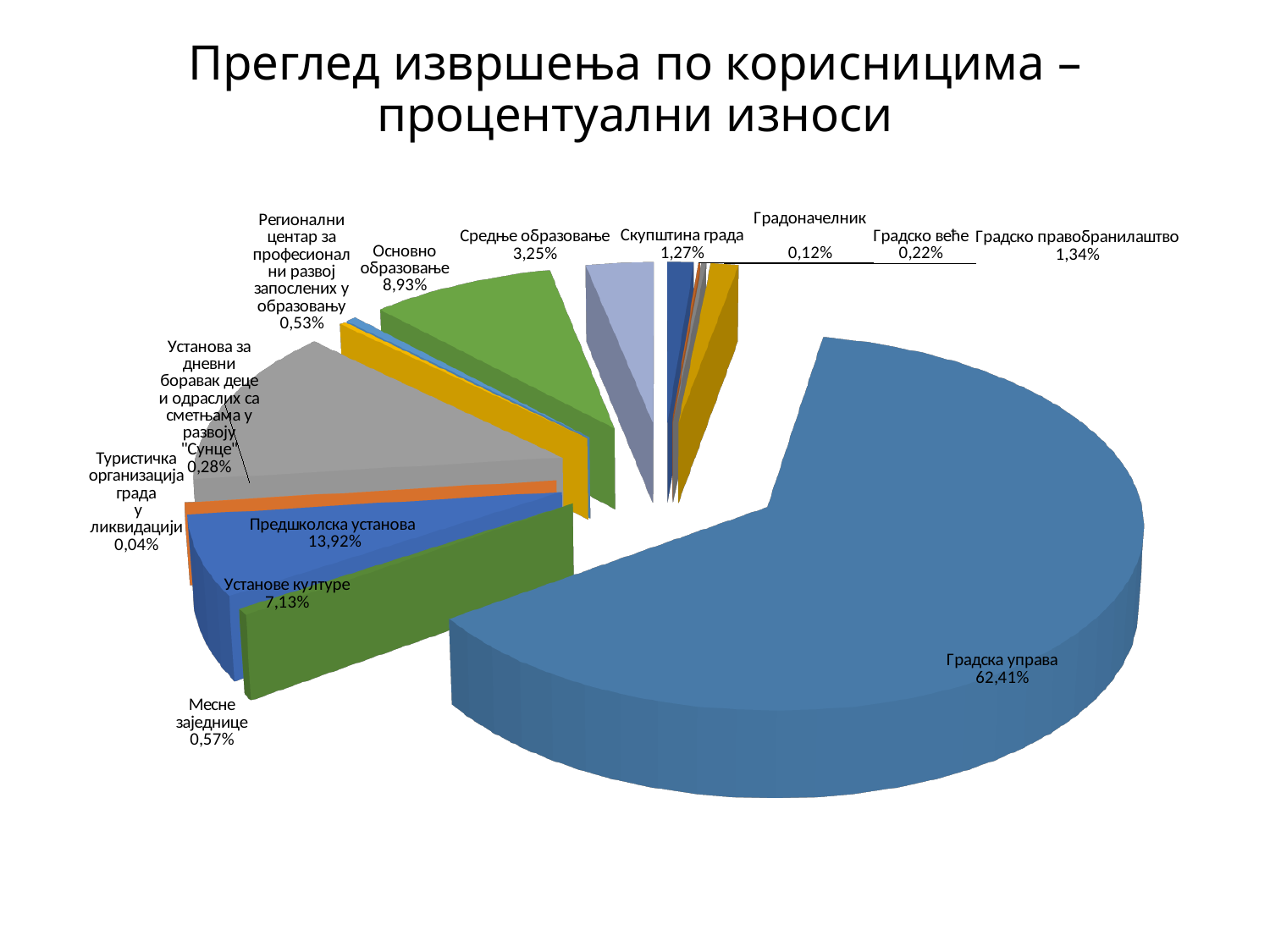
Which has a larger share, Средње образовање or Скупштина града? Средње образовање What is the title of the chart on the slide? Преглед извршења по корисницима – процентуални износи What percentage is shown for Градска управа? 62,41% Which category has the smallest share of the pie? Туристичка организација града у ликвидацији Which category has the largest share of the pie? Градска управа What is the difference between the shares of Предшколска установа and Установе културе? 6,79% What is the share of Месне заједнице in the pie? 0,57% What kind of chart is shown on the slide? Pie chart What percentage is shown for Градско правобранилаштво? 1,34% What percentage is shown for Предшколска установа? 13,92% How many categories are shown in the pie chart? 13 What percentage is shown for Основно образовање? 8,93%